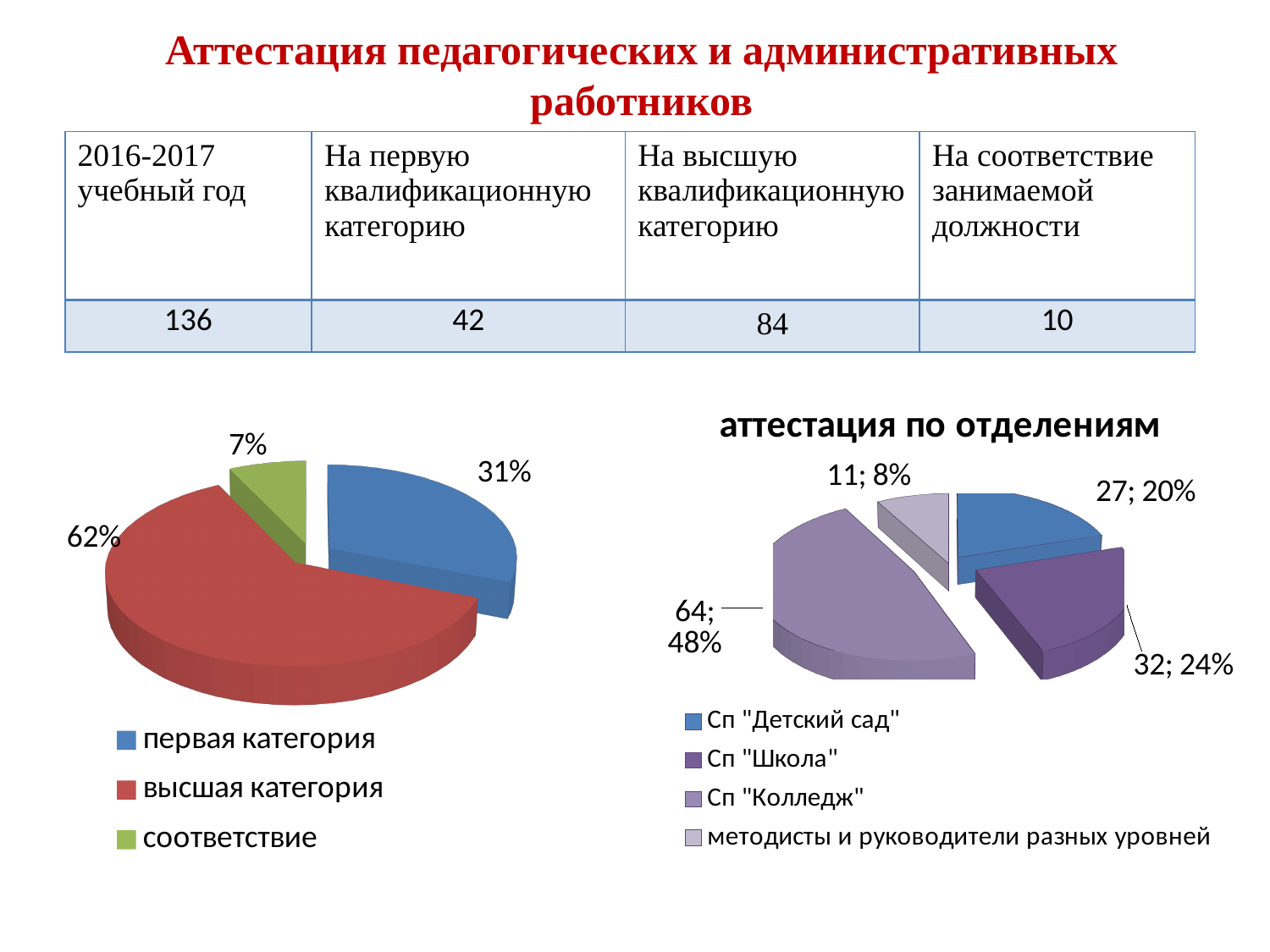
What is the title of the right pie chart? аттестация по отделениям In the left pie chart, what share does "первая категория" have? 31% In the left pie chart, which category has the smallest slice? соответствие In the left pie chart, what share does "высшая категория" have? 62% In the chart titled "аттестация по отделениям", what is the value for "методисты и руководители разных уровней"? 11 In the chart titled "аттестация по отделениям", what share does Сп "Школа" have? 24% In the left pie chart, which category has the largest slice? высшая категория In the chart titled "аттестация по отделениям", what is the difference between the values for Сп "Школа" and Сп "Детский сад"? 5 In the chart titled "аттестация по отделениям", what is the value for Сп "Колледж"? 64 In the chart titled "аттестация по отделениям", which category has the largest slice? Сп "Колледж" What kind of chart is the left chart on the slide? pie chart How many categories does the legend of the left pie chart list? 3